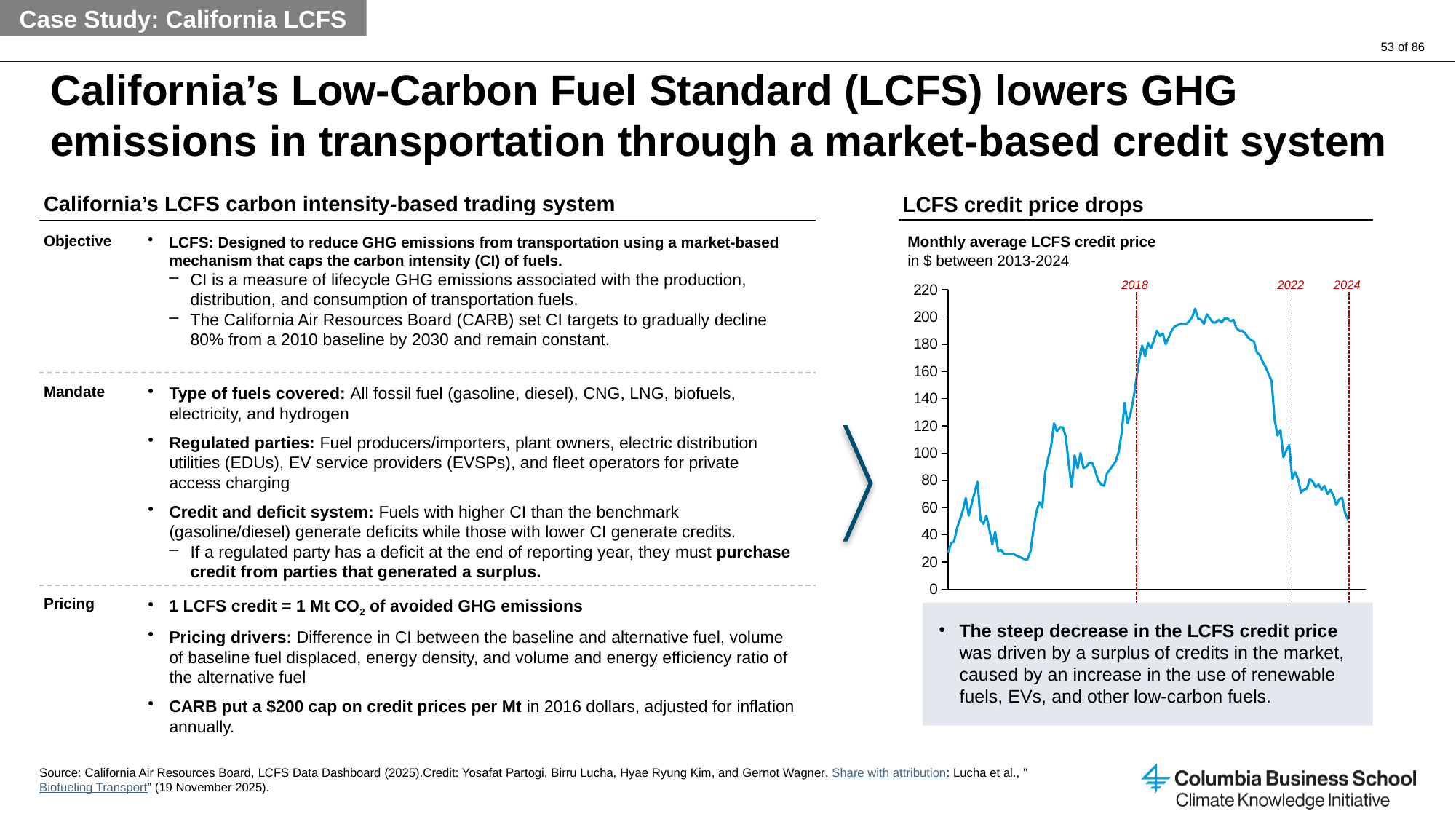
What is the highest value shown on the y axis of the LCFS credit price chart? 220 Which is higher on the LCFS credit price chart: the price at the 2018 marker or the price at the 2024 marker? 2018 Is the LCFS credit price at the 2018 marker greater or less than 120? greater Is the LCFS credit price at the 2024 marker greater or less than 80? less Does the LCFS credit price rise or fall between the 2022 marker and the 2024 marker? fall Is the peak LCFS credit price on the chart greater or less than 180? greater Which years are marked with red dashed vertical lines on the LCFS credit price chart? 2018, 2024 How many data series are plotted on the LCFS credit price chart? 1 What kind of chart is used to show the monthly average LCFS credit price? line chart In what unit is the LCFS credit price plotted? $